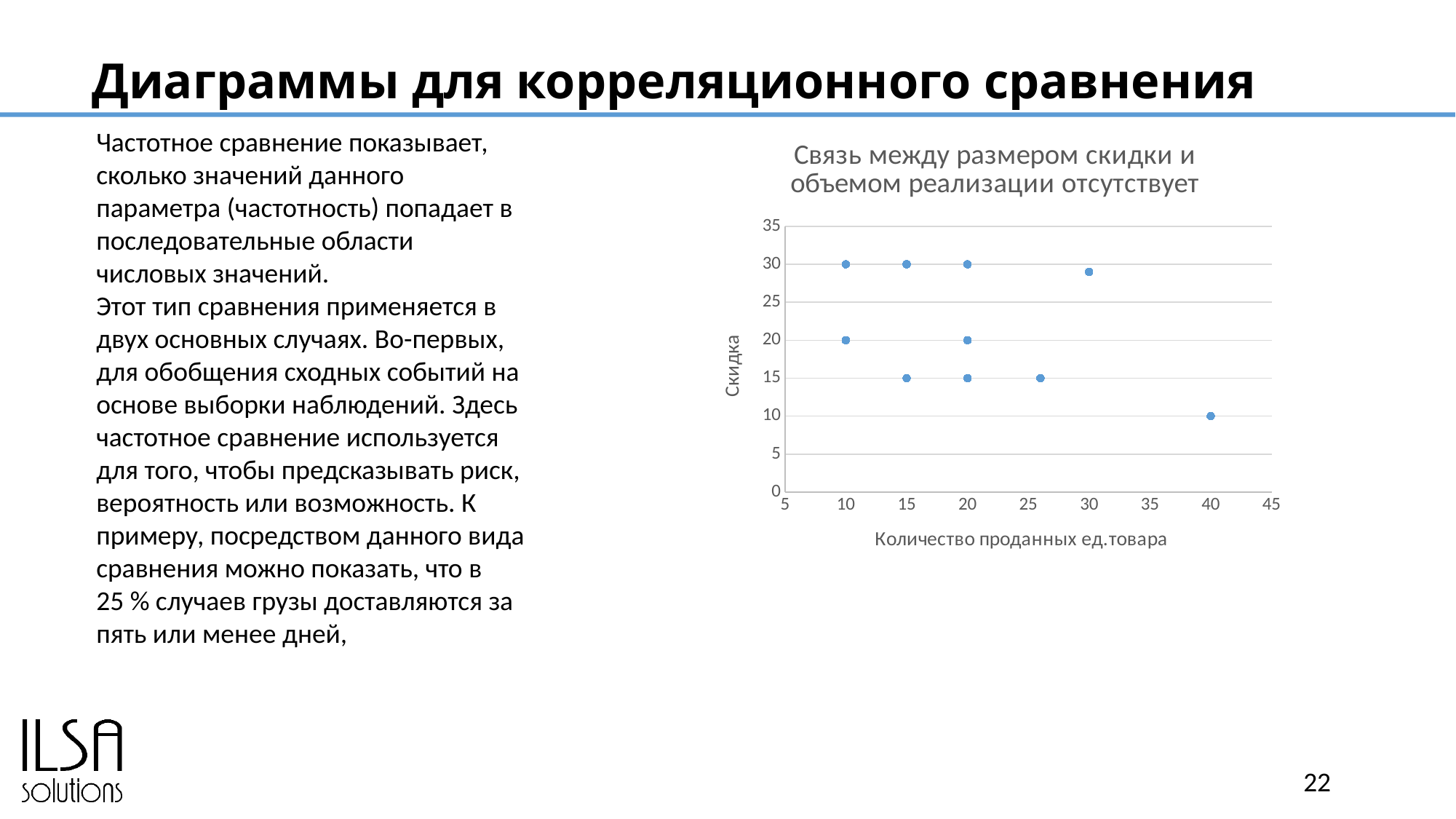
What is the highest discount value plotted on the chart? 30 What is the title of the chart? Связь между размером скидки и объемом реализации отсутствует What is the lowest discount value plotted on the chart? 10 Is the discount for the point at 40 units sold greater or less than 15? less What is the largest number of units sold among the plotted points? 40 Is the discount for the point at 30 units sold greater or less than 25? greater What is the discount (Скидка) for the point at 40 units sold? 10 Which has the larger discount: the point at 40 units sold or the point at 30 units sold? The point at 30 units sold What kind of chart is shown on the slide? Scatter chart What is the label of the horizontal axis of the chart? Количество проданных ед.товара How many data points are plotted on the chart? 10